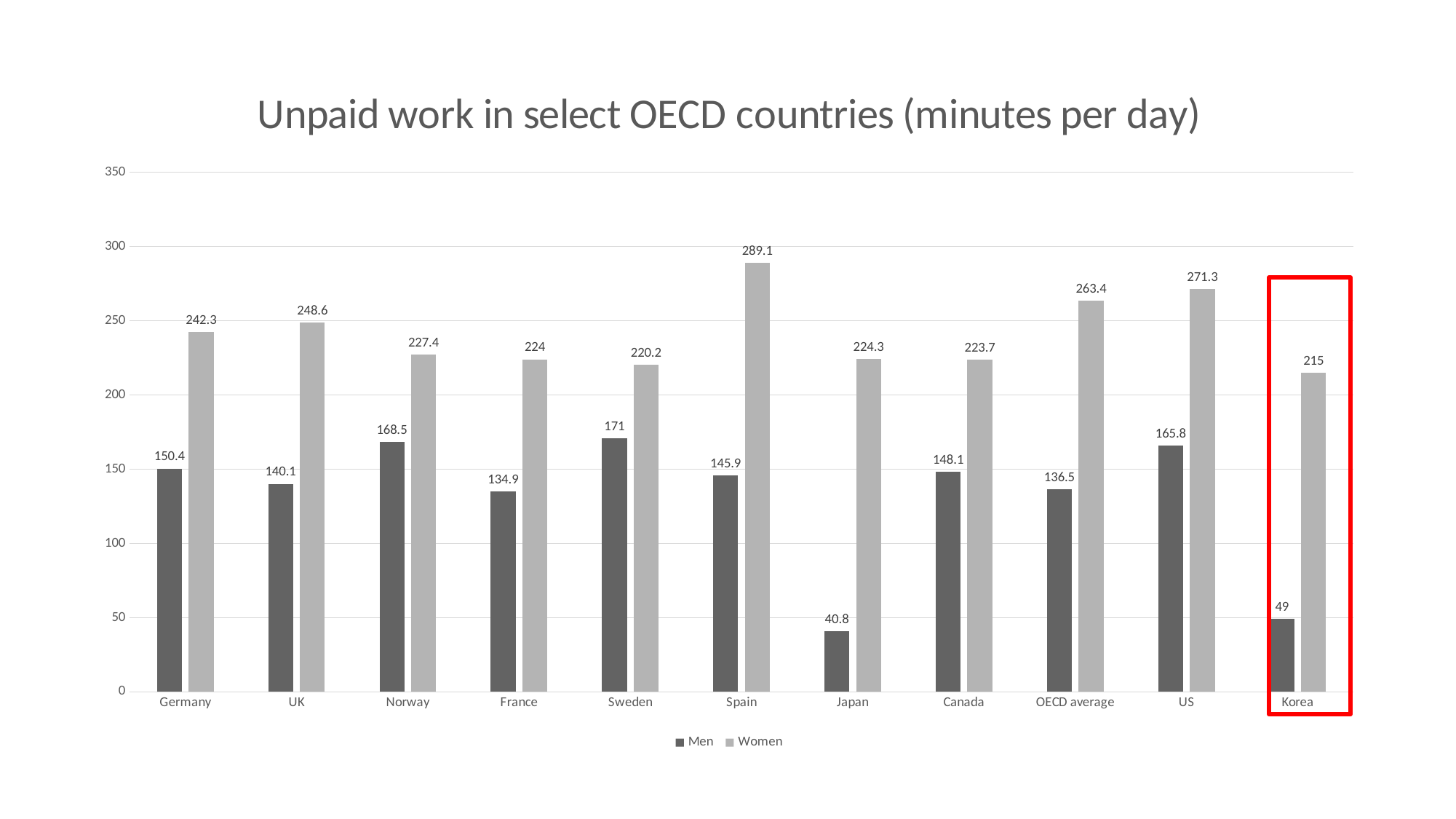
What is the difference between the Women and Men values for Korea? 166 What is the value for Men in Japan? 40.8 Which country has the highest value for Men? Sweden What is the value for Women for the OECD average? 263.4 How many categories are shown on the x axis? 11 How many series does the legend list? 2 Which country has the lowest value for Men? Japan Which country has the highest value for Women? Spain What is the value for Women in Spain? 289.1 What is the value for Men in Korea? 49 What kind of chart is shown on the slide? Bar chart Which is larger, the Men value for Norway or the Men value for the US? Norway